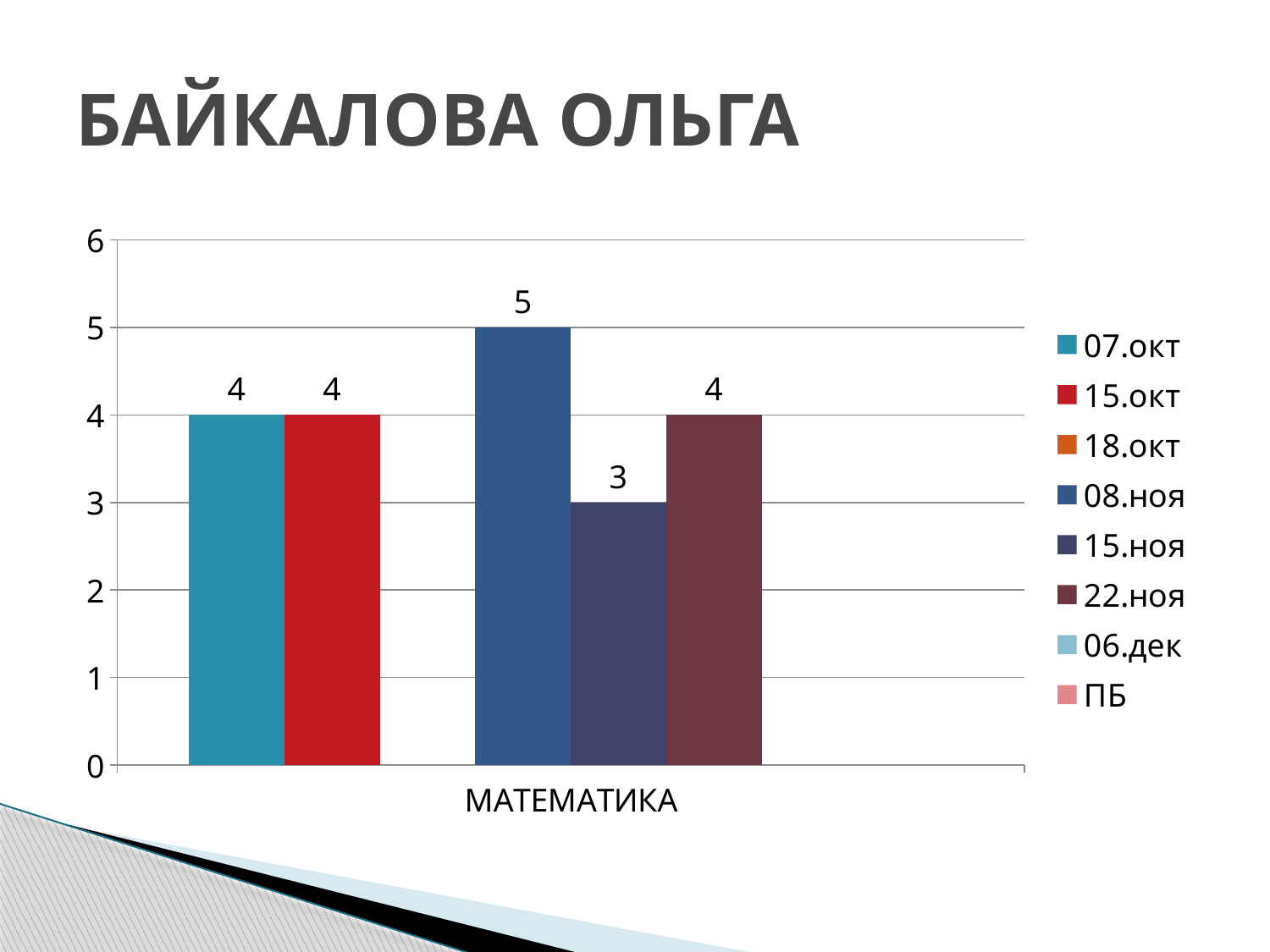
What is the value for 07.окт in МАТЕМАТИКА? 4 Which series has the highest value in МАТЕМАТИКА? 08.ноя Which series has the lowest value in МАТЕМАТИКА? 15.ноя What is the value for 15.ноя in МАТЕМАТИКА? 3 How many series does the legend list? 8 What is the value for 22.ноя in МАТЕМАТИКА? 4 How many categories are shown on the x axis? 1 What is the title of the slide above the chart? БАЙКАЛОВА ОЛЬГА What kind of chart is shown on the slide? bar chart Which is larger, the value for 08.ноя or the value for 22.ноя? 08.ноя What is the difference between the values for 08.ноя and 15.ноя? 2 What is the value for 08.ноя in МАТЕМАТИКА? 5